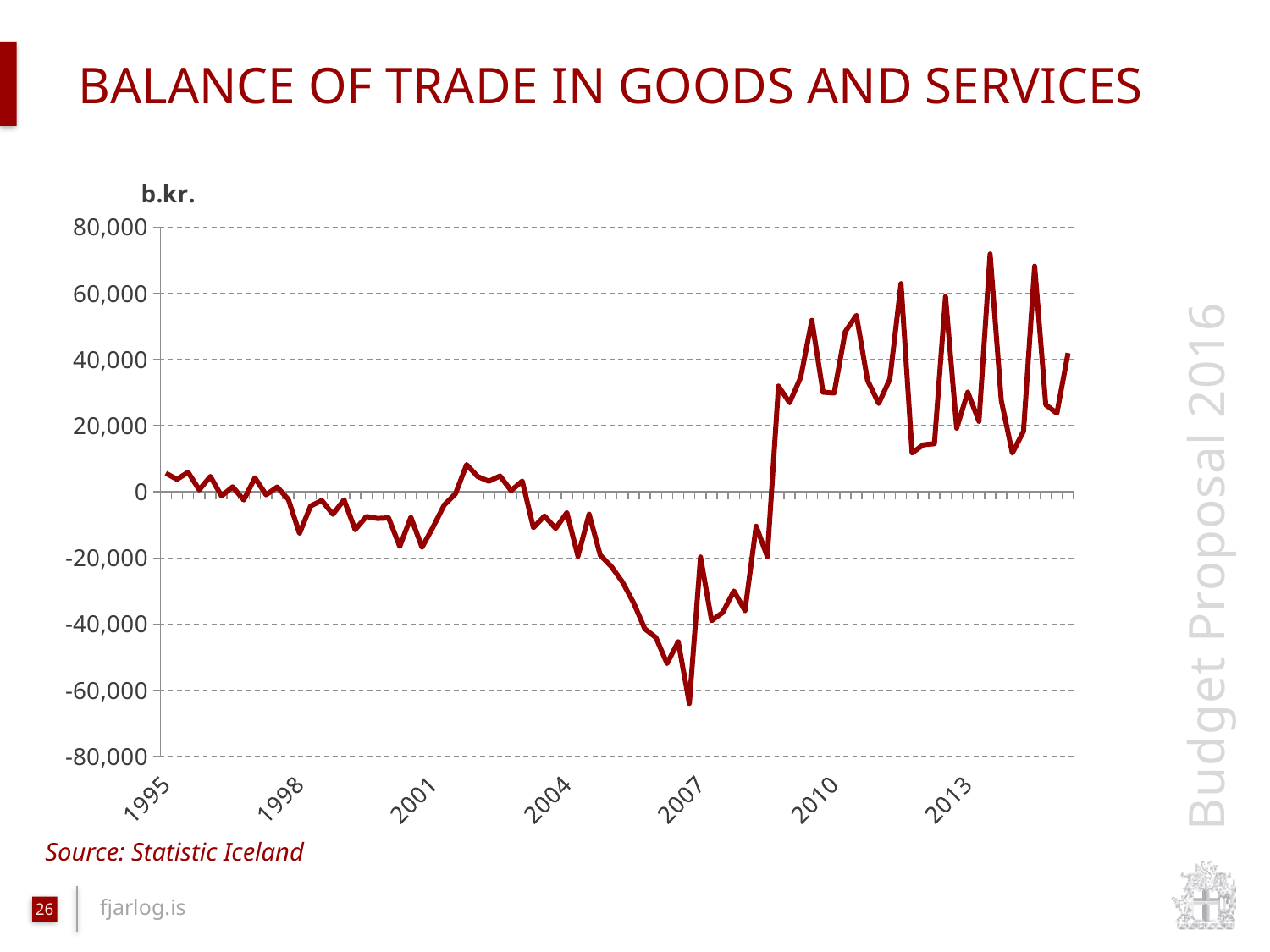
How many lines are plotted on the chart? 1 What kind of chart is shown on the slide? line chart Is the highest value on the chart, reached after 2013, greater or less than 60,000? greater Around which labelled year does the line reach its lowest value? 2007 Is the value at 2010 greater or less than 0? greater Do the values rise or fall between 2004 and 2007? fall What is the title of the chart? BALANCE OF TRADE IN GOODS AND SERVICES Is the value at 1995 greater or less than 0? greater How many year labels are shown on the x axis? 7 Do the values rise or fall between 2007 and 2010? rise What unit is shown above the vertical axis of the chart? b.kr.